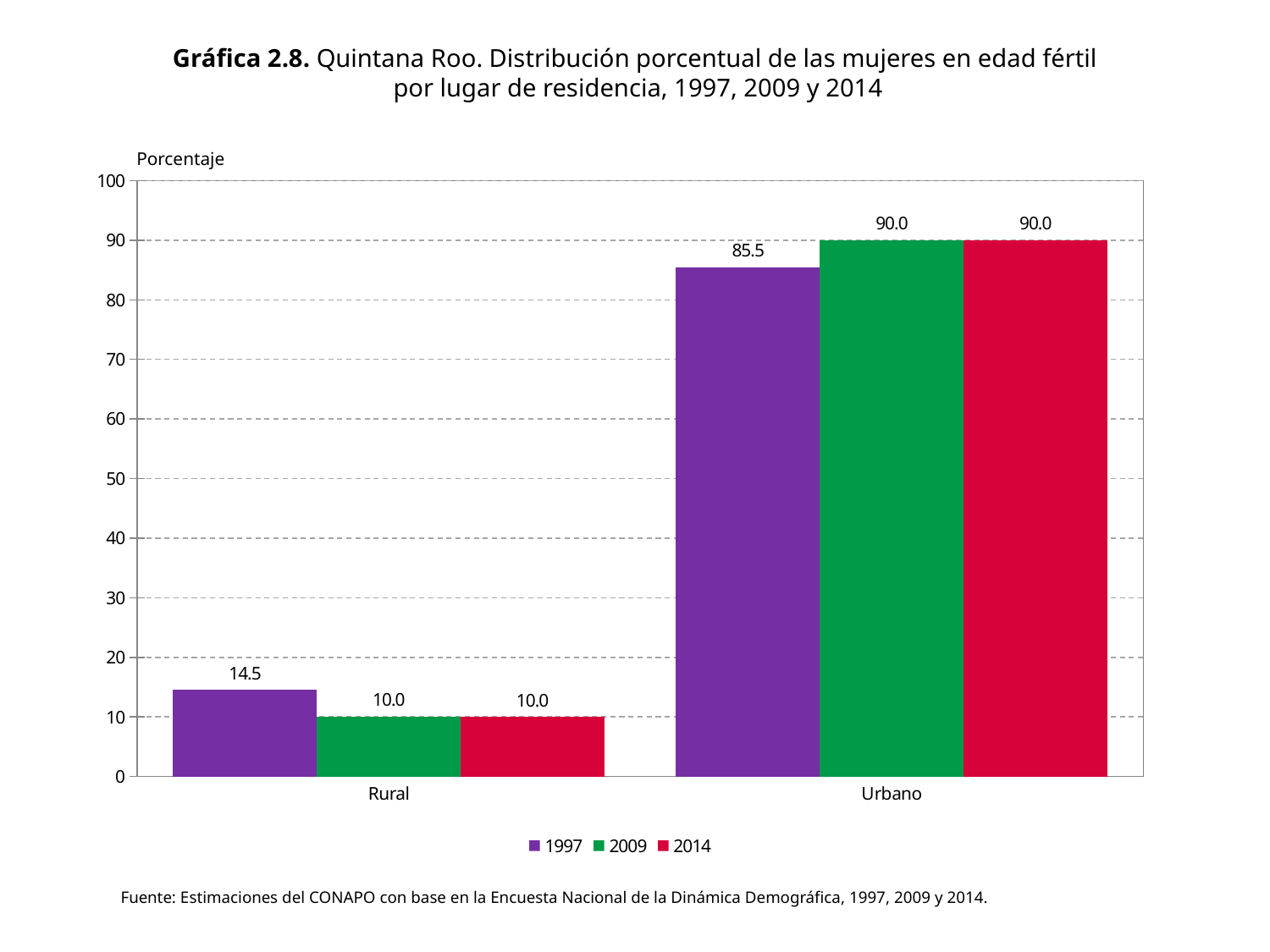
What is the value for Urbano in 2009? 90.0 What kind of chart is shown on the slide? Bar chart Which is larger, the Rural value for 1997 or the Rural value for 2009? 1997 Which category has the highest value in the 1997 series? Urbano What is the value for Rural in 2014? 10.0 Which category has the lowest value in the 2014 series? Rural What is the difference between the Urbano and Rural values in 1997? 71.0 How many series does the legend list? 3 What is the difference between the Urbano values for 2009 and 1997? 4.5 How many categories are shown on the x axis? 2 What is the value for Urbano in 1997? 85.5 What is the value for Rural in 1997? 14.5